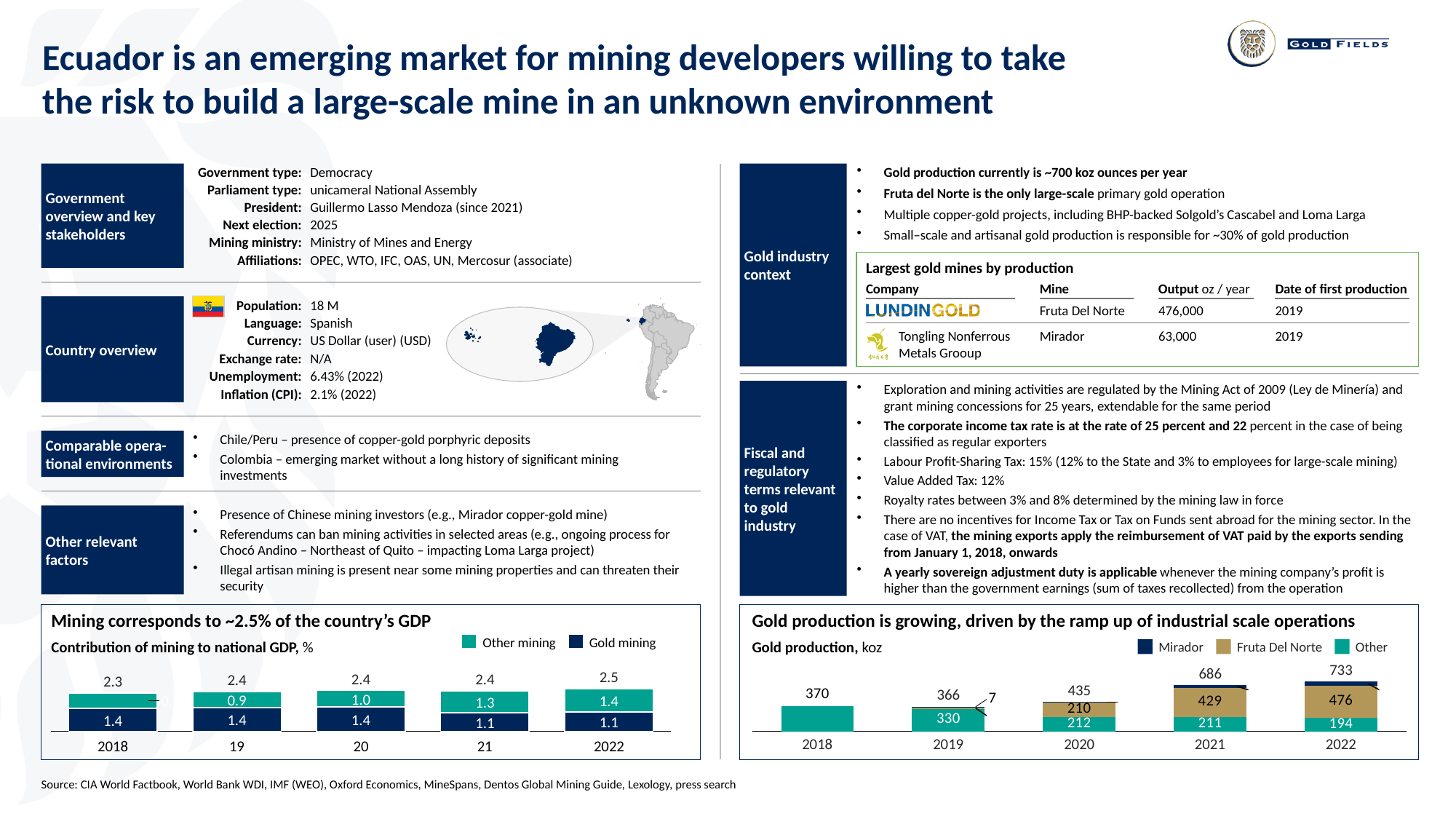
On the 'Gold production, koz' chart, is the 'Other' value in 2022 larger or smaller than the Fruta Del Norte value in 2022? smaller On the 'Contribution of mining to national GDP, %' chart, what was the gold mining contribution in 2021? 1.1 On the 'Gold production, koz' chart, which year has the lowest total gold production? 2019 On the 'Contribution of mining to national GDP, %' chart, does the total contribution rise or fall from 2018 to 2022? Rise On the 'Gold production, koz' chart, how much higher was total production in 2022 than in 2018? 363 On the 'Gold production, koz' chart, how many series does the legend list? 3 On the 'Contribution of mining to national GDP, %' chart, what was the total contribution of mining to GDP in 2022? 2.5 On the 'Gold production, koz' chart, what was total gold production in 2022? 733 On the 'Gold production, koz' chart, what was Fruta Del Norte's production in 2021? 429 What kind of chart is the 'Contribution of mining to national GDP, %' chart? Stacked bar chart On the 'Contribution of mining to national GDP, %' chart, how many years are shown on the x axis? 5 On the 'Gold production, koz' chart, which year has the highest total gold production? 2022